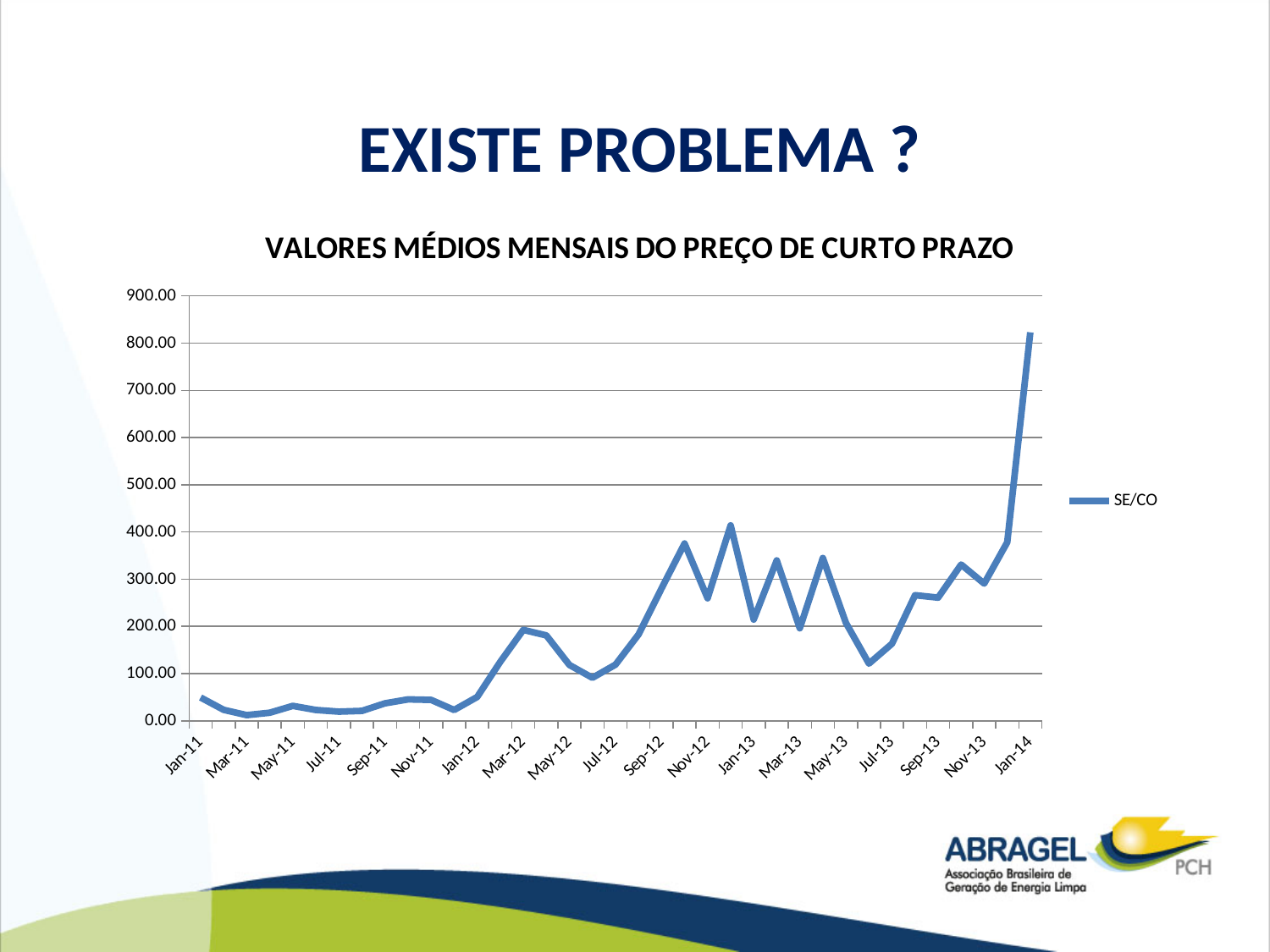
Which is larger, the SE/CO value for Sep-12 or for Sep-11? Sep-12 What is the name of the series shown in the legend? SE/CO Is the SE/CO value for Jan-14 greater or less than 700? greater What kind of chart is shown on the slide? line chart How many series does the legend list? 1 Is the SE/CO value for Jan-11 greater or less than 100? less Is the SE/CO value for Jan-13 greater or less than 300? less What is the title of the chart? VALORES MÉDIOS MENSAIS DO PREÇO DE CURTO PRAZO Which is larger, the SE/CO value for Jan-14 or for Jan-13? Jan-14 Which month has the highest SE/CO value? Jan-14 Overall, does the SE/CO value rise or fall from Jan-11 to Jan-14? rise